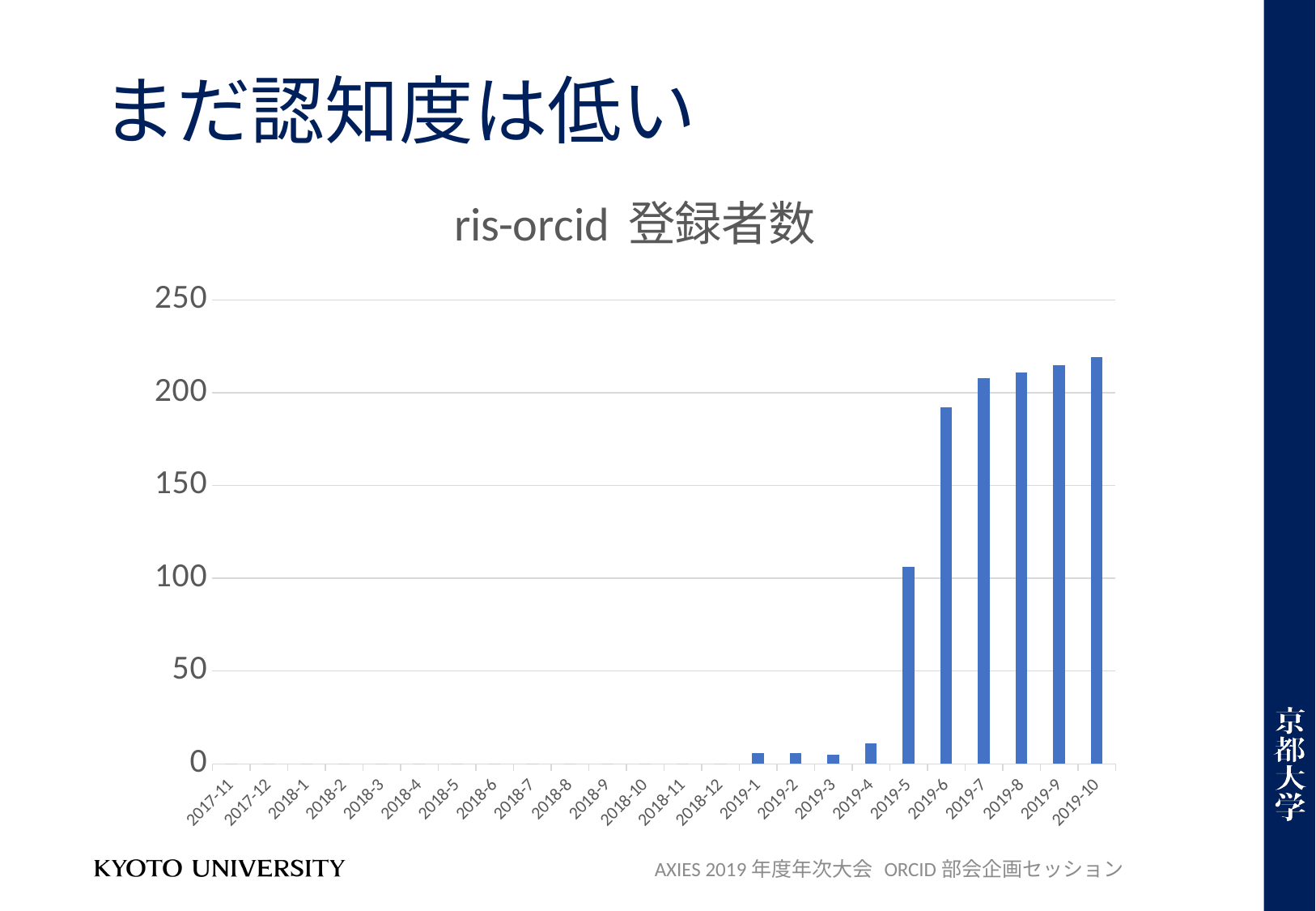
How many months are listed along the x axis of the chart? 24 What is the first month on the x axis that shows a visible bar? 2019-1 Is the value for 2019-7 greater or less than 200? greater Do the values generally rise or fall from 2019-1 to 2019-10? rise Is the value for 2019-5 greater or less than 100? greater Is the value for 2019-4 greater or less than 50? less Which is larger, the value for 2019-5 or the value for 2019-6? 2019-6 What is the title of the chart? ris-orcid 登録者数 What kind of chart is shown on the slide? bar chart Which month has the highest bar in the chart? 2019-10 Which is larger, the value for 2019-1 or the value for 2019-10? 2019-10